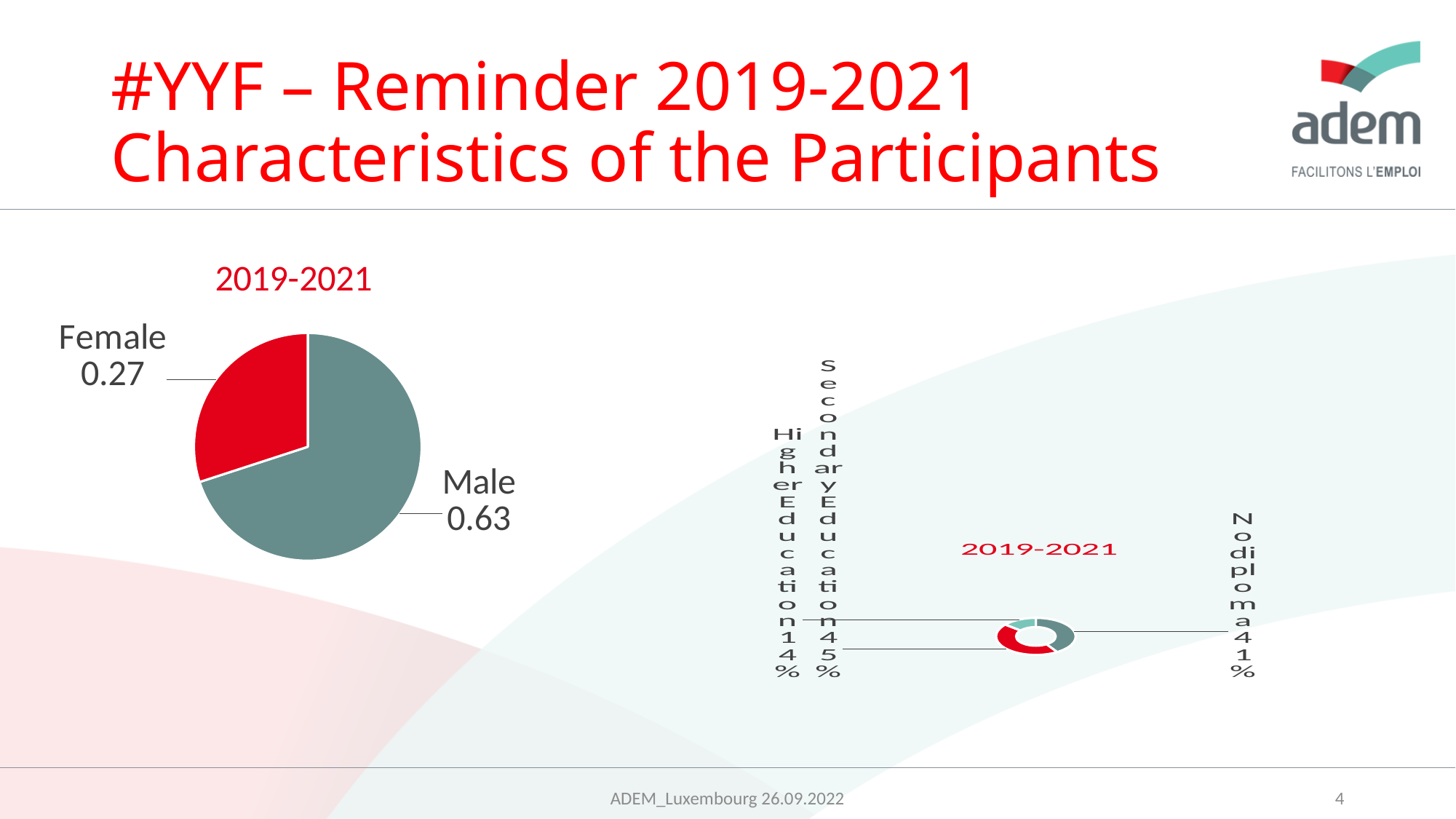
In the pie chart on the left, what is the value shown for Female? 0.27 In the doughnut chart on the right, what percentage is shown for No diploma? 41% In the pie chart on the left, what is the value shown for Male? 0.63 In the doughnut chart on the right, what percentage is shown for Higher Education? 14% In the doughnut chart on the right, which category has the largest share? Secondary Education How many slices does the pie chart on the left have? 2 In the pie chart on the left, which slice is larger, Male or Female? Male What kind of chart is the chart on the left of the slide? Pie chart In the doughnut chart on the right, which category has the smallest share? Higher Education How many categories are shown in the doughnut chart on the right? 3 In the pie chart on the left, what is the difference between the Male value and the Female value? 0.36 In the doughnut chart on the right, what percentage is shown for Secondary Education? 45%